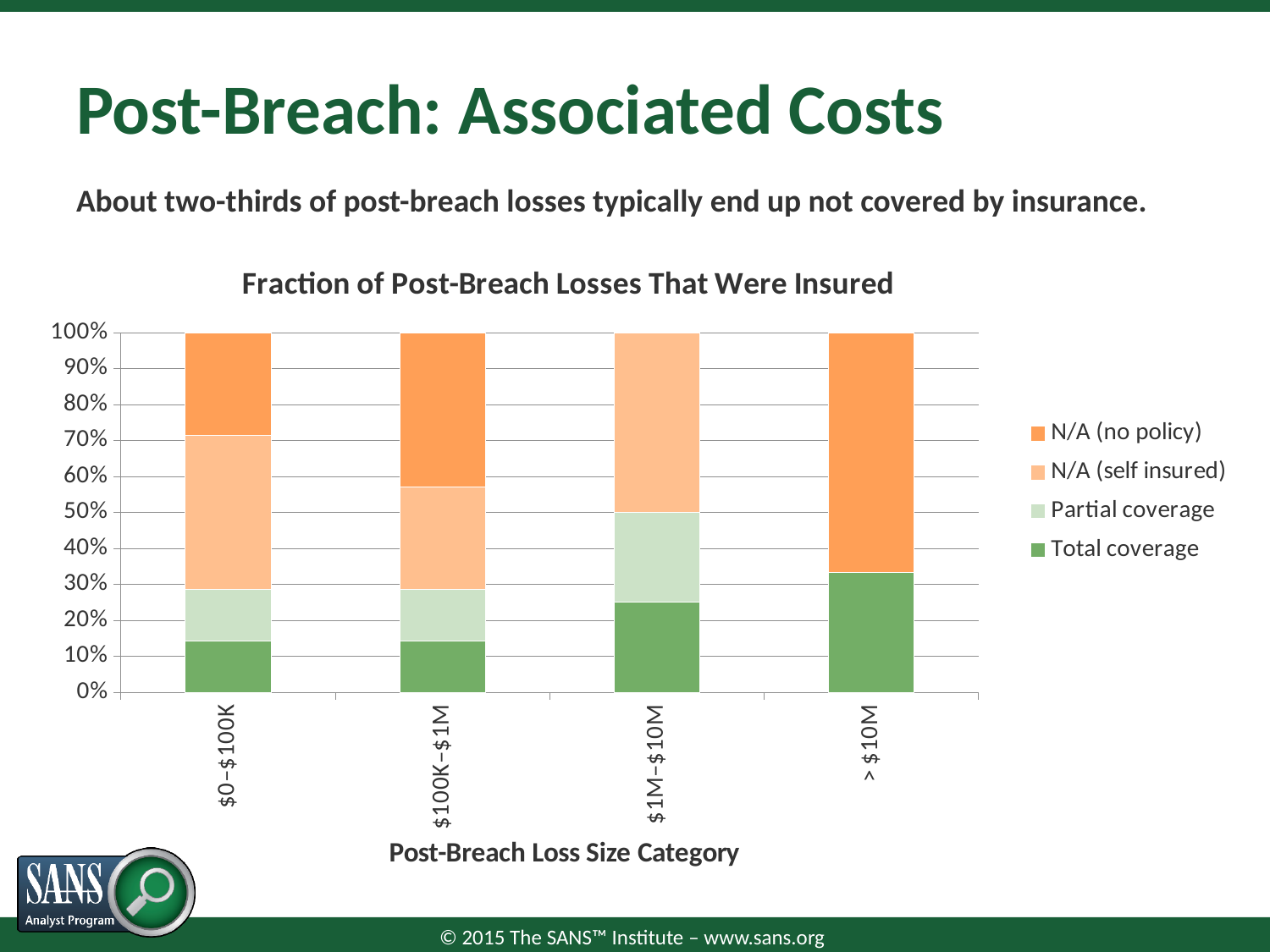
Which category has no N/A (no policy) segment? $1M–$10M What is the total height of the stacked bar for $0–$100K? 100% What is the x-axis title of the chart? Post-Breach Loss Size Category Which is larger, the Total coverage segment for > $10M or for $100K–$1M? > $10M What kind of chart is shown on the slide? Stacked bar chart Is the Total coverage value for $0–$100K greater or less than 20%? less What is the title of the chart? Fraction of Post-Breach Losses That Were Insured Which category has the largest Total coverage segment? > $10M How many series does the legend list? 4 Is the Total coverage value for > $10M greater or less than 30%? greater How many loss size categories are shown on the x axis? 4 Is the Total coverage value for $1M–$10M greater or less than 20%? greater